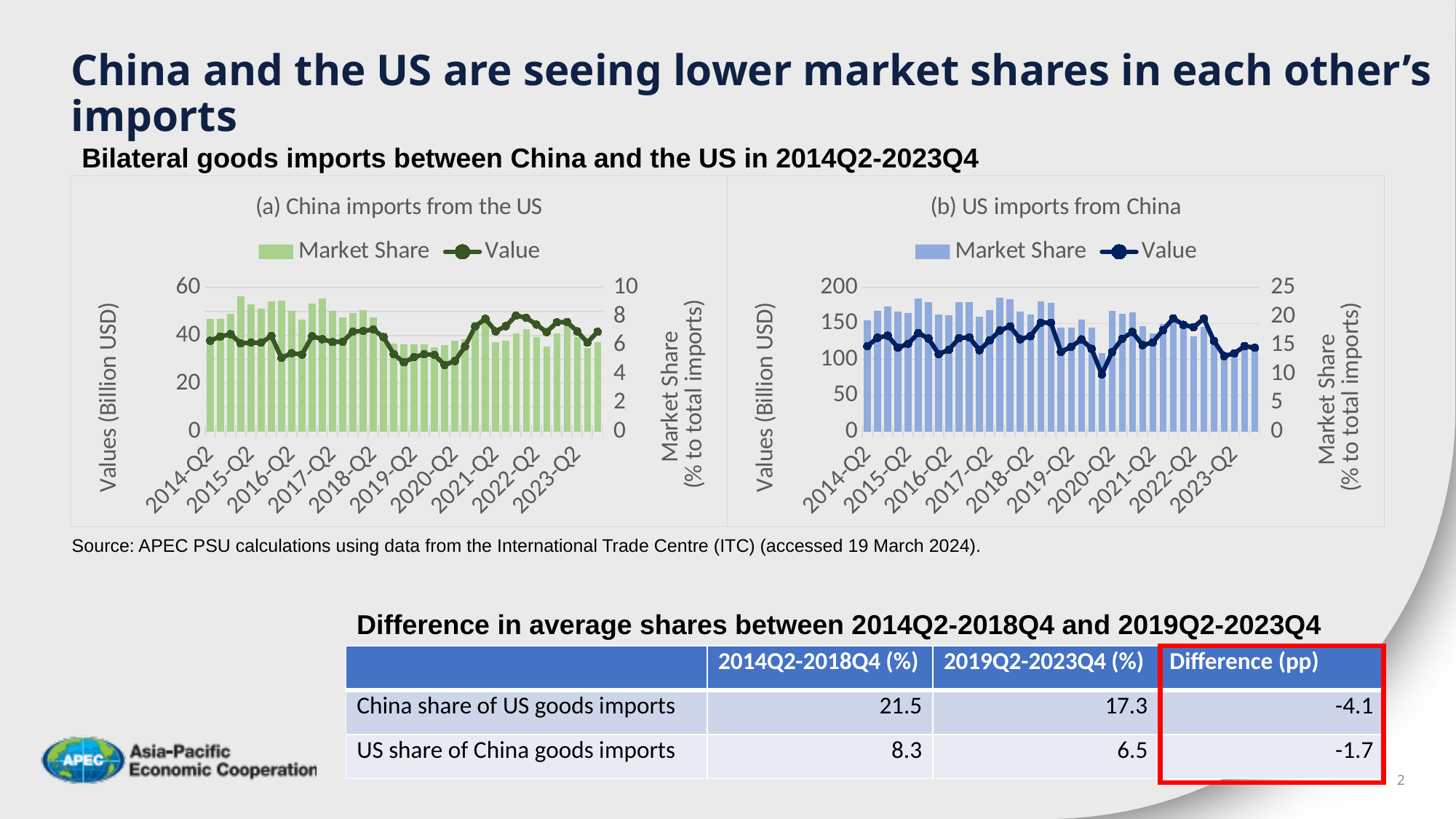
What kind of chart is chart (a) 'China imports from the US'? A combined bar and line chart What is the title of the left vertical axis in chart (b) 'US imports from China'? Values (Billion USD) How many quarter labels are shown on the x axis of chart (a) 'China imports from the US'? 10 In chart (b) 'US imports from China', does the line generally rise or fall between 2022-Q2 and 2023-Q2? fall What are the two legend entries in chart (a) 'China imports from the US'? Market Share and Value In chart (b) 'US imports from China', is the bar at 2018-Q2 greater or less than 150 on the left axis? greater In chart (a) 'China imports from the US', is the bar at 2020-Q2 greater or less than 40 on the left axis? less In chart (b) 'US imports from China', is the line higher at 2018-Q2 or at 2020-Q2? 2018-Q2 In chart (a) 'China imports from the US', which bar is taller: 2015-Q2 or 2020-Q2? 2015-Q2 How many series does the legend of chart (b) 'US imports from China' list? 2 In chart (b) 'US imports from China', is the line value at 2020-Q2 greater or less than 15 on the right axis? less